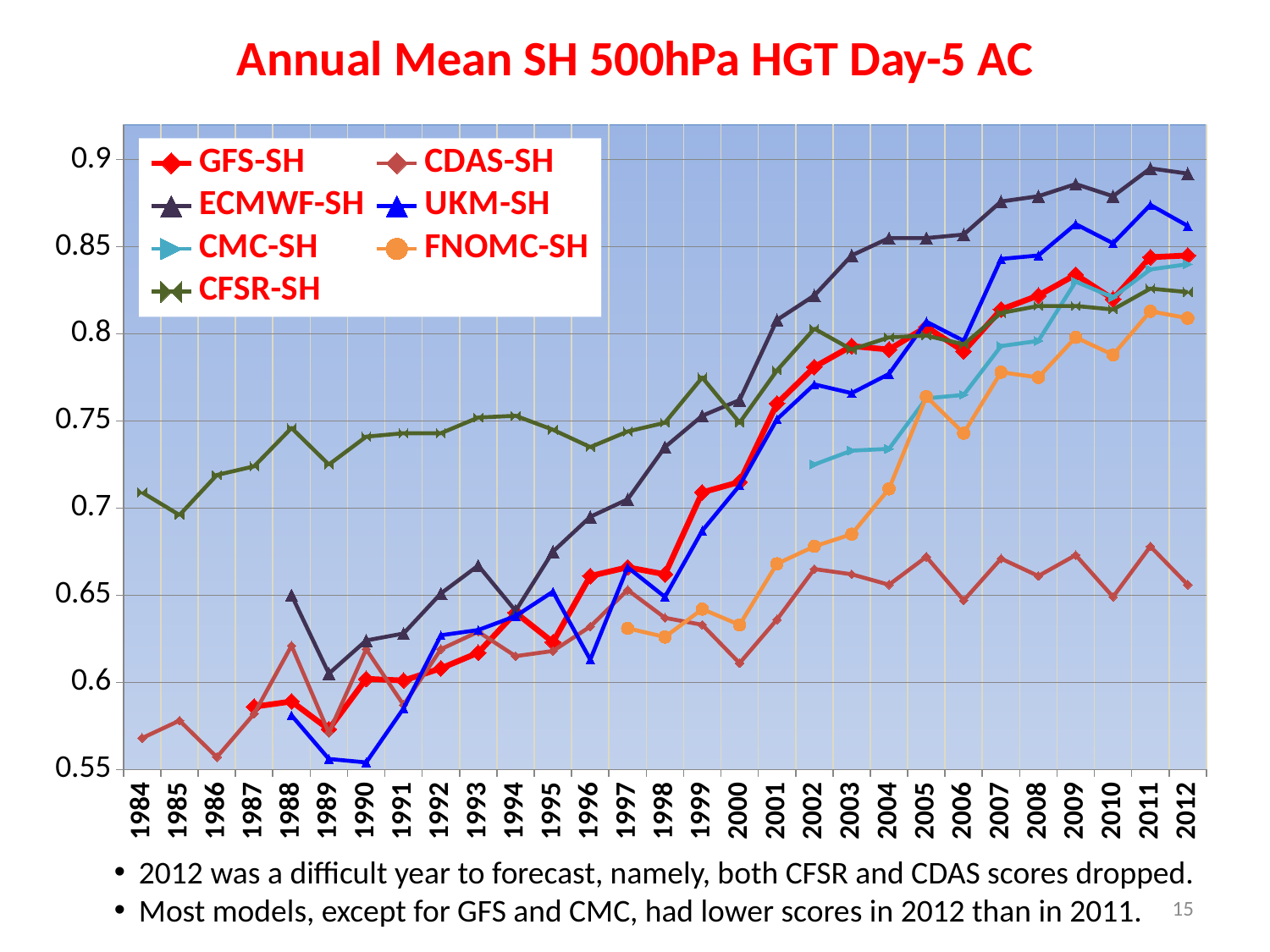
What kind of chart is shown on the slide? line chart Is the value for GFS-SH in 2012 greater or less than 0.8? greater Is the value for UKM-SH in 1990 greater or less than 0.6? less Which series has the highest value in 2012? ECMWF-SH What is the title of the chart? Annual Mean SH 500hPa HGT Day-5 AC Is the value for FNOMC-SH in 1997 greater or less than 0.65? less Which series has the lowest value in 2012? CDAS-SH In 1990, which series has the larger value, CFSR-SH or GFS-SH? CFSR-SH How many series does the legend list? 7 How many years are shown along the x axis? 29 Does the GFS-SH series generally rise or fall from 1984 to 2012? rise